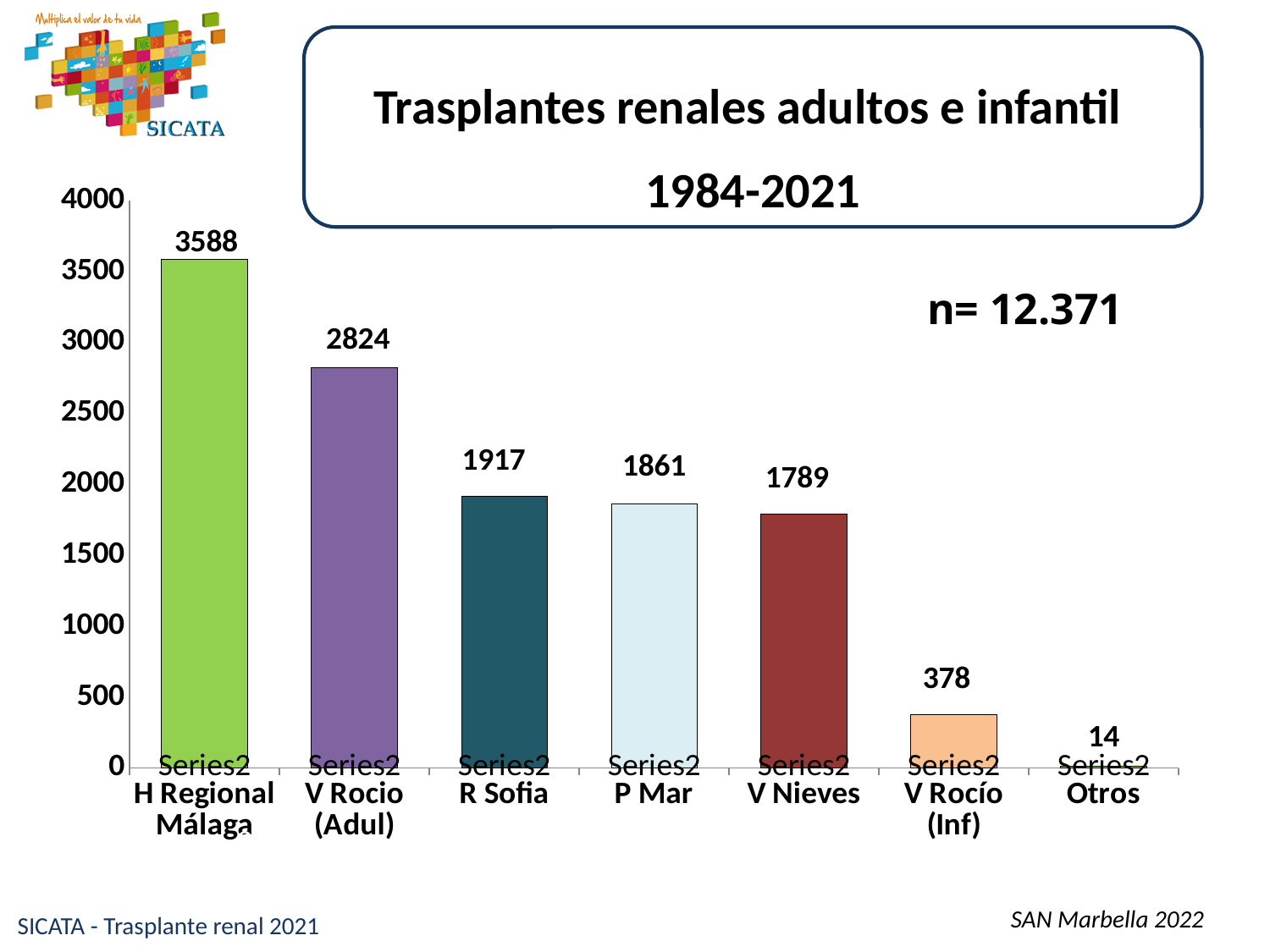
What is the value for V Rocio (Adul)? 2824 What is the value for H Regional Málaga? 3588 What is the title of the chart? Trasplantes renales adultos e infantil 1984-2021 Which is larger, the value for R Sofia or the value for V Nieves? R Sofia Which category has the highest value? H Regional Málaga Which category has the lowest value? Otros What kind of chart is shown on the slide? bar chart How many categories are shown on the x axis? 7 Is the value for V Nieves greater or less than 2000? less What is the value for V Rocío (Inf)? 378 What is the value for P Mar? 1861 What is the difference between the values for H Regional Málaga and V Rocio (Adul)? 764